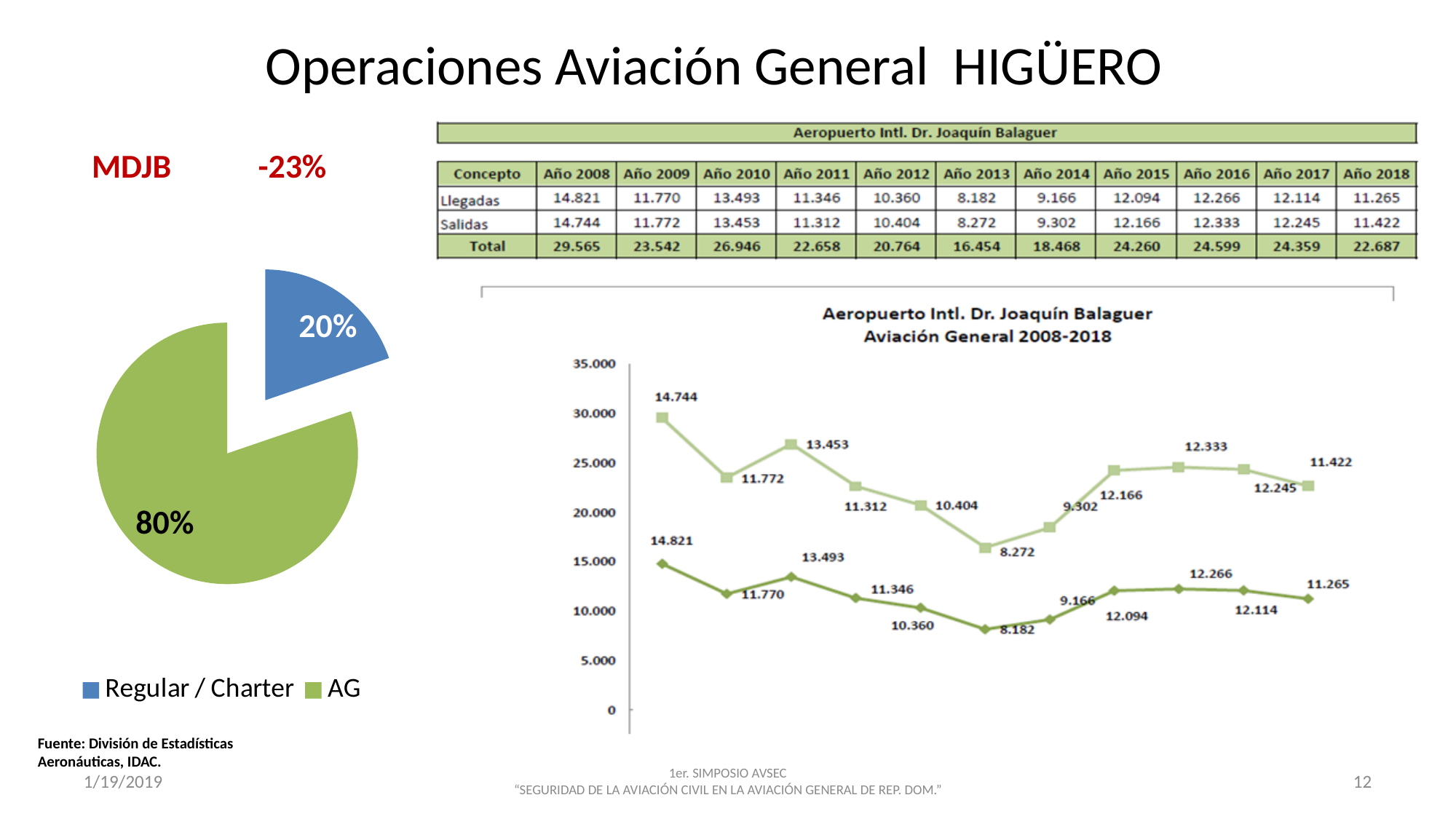
In the chart titled 'Aeropuerto Intl. Dr. Joaquín Balaguer Aviación General 2008-2018', is the lower (dark green) line higher or lower at its last point than at its first point? lower In the chart titled 'Aeropuerto Intl. Dr. Joaquín Balaguer Aviación General 2008-2018', what is the data label on the last point of the lower (dark green) line? 11.265 In the pie chart on the left, what is the difference in percentage points between the AG slice and the Regular / Charter slice? 60 In the chart titled 'Aeropuerto Intl. Dr. Joaquín Balaguer Aviación General 2008-2018', what is the data label on the first point of the lower (dark green) line? 14.821 In the pie chart on the left, what share does Regular / Charter have? 20% In the pie chart on the left, which slice is larger, Regular / Charter or AG? AG In the pie chart on the left, what share does AG have? 80% In the chart titled 'Aeropuerto Intl. Dr. Joaquín Balaguer Aviación General 2008-2018', what is the data label on the last point of the upper (light green) line? 11.422 In the pie chart on the left, how many entries does the legend list? 2 What kind of chart is the chart titled 'Aeropuerto Intl. Dr. Joaquín Balaguer Aviación General 2008-2018'? line chart In the chart titled 'Aeropuerto Intl. Dr. Joaquín Balaguer Aviación General 2008-2018', what is the smallest data label on the lower (dark green) line? 8.182 In the chart titled 'Aeropuerto Intl. Dr. Joaquín Balaguer Aviación General 2008-2018', how many data points does each line have? 11